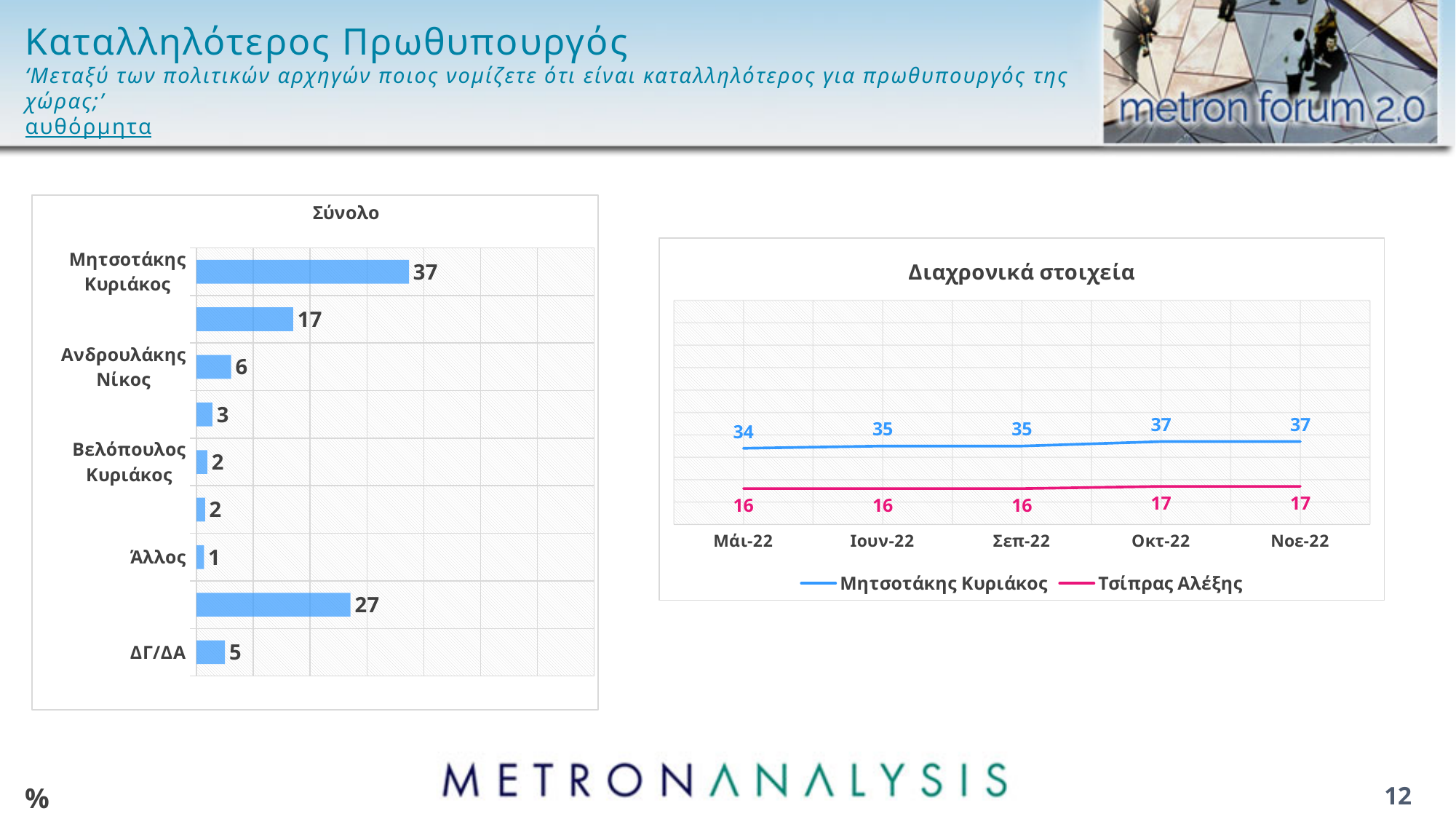
In the 'Διαχρονικά στοιχεία' chart, how many series does the legend list? 2 In the 'Σύνολο' chart, what is the difference between the values for Μητσοτάκης Κυριάκος and Ανδρουλάκης Νίκος? 31 In the 'Σύνολο' chart, what is the value for Ανδρουλάκης Νίκος? 6 In the 'Σύνολο' chart, which labelled category has the highest value? Μητσοτάκης Κυριάκος In the 'Διαχρονικά στοιχεία' chart, what is the value for Τσίπρας Αλέξης in Νοε-22? 17 In the 'Διαχρονικά στοιχεία' chart, what is the value for Μητσοτάκης Κυριάκος in Μάι-22? 34 In the 'Διαχρονικά στοιχεία' chart, how many time points are plotted on the x axis? 5 In the 'Σύνολο' chart, which is larger: the value for Βελόπουλος Κυριάκος or the value for ΔΓ/ΔΑ? ΔΓ/ΔΑ What kind of chart is the 'Σύνολο' chart? Bar chart In the 'Διαχρονικά στοιχεία' chart, what is the difference between Μητσοτάκης Κυριάκος and Τσίπρας Αλέξης in Οκτ-22? 20 In the 'Σύνολο' chart, what is the value for Μητσοτάκης Κυριάκος? 37 In the 'Σύνολο' chart, what is the value for ΔΓ/ΔΑ? 5